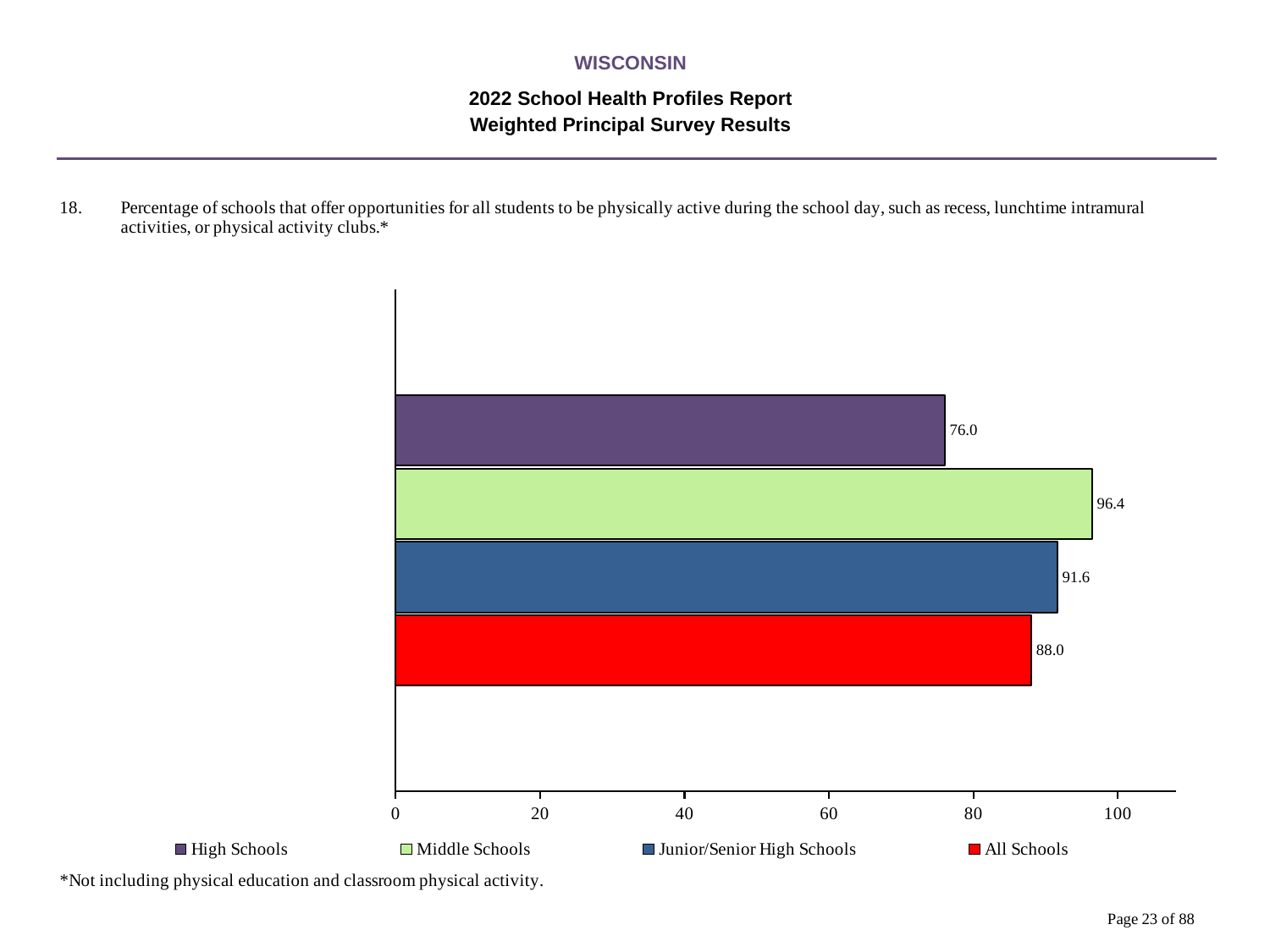
What kind of chart is shown on the slide? Bar chart How many series does the legend list? 4 What is the difference between the values for Middle Schools and High Schools? 20.4 What is the value for High Schools? 76.0 Is the value for High Schools greater or less than 80? less Which school type has the lowest value? High Schools Which is larger, the value for Junior/Senior High Schools or the value for All Schools? Junior/Senior High Schools Which school type has the highest value? Middle Schools What is the value for Junior/Senior High Schools? 91.6 What is the difference between the values for Junior/Senior High Schools and All Schools? 3.6 What is the value for All Schools? 88.0 What is the value for Middle Schools? 96.4